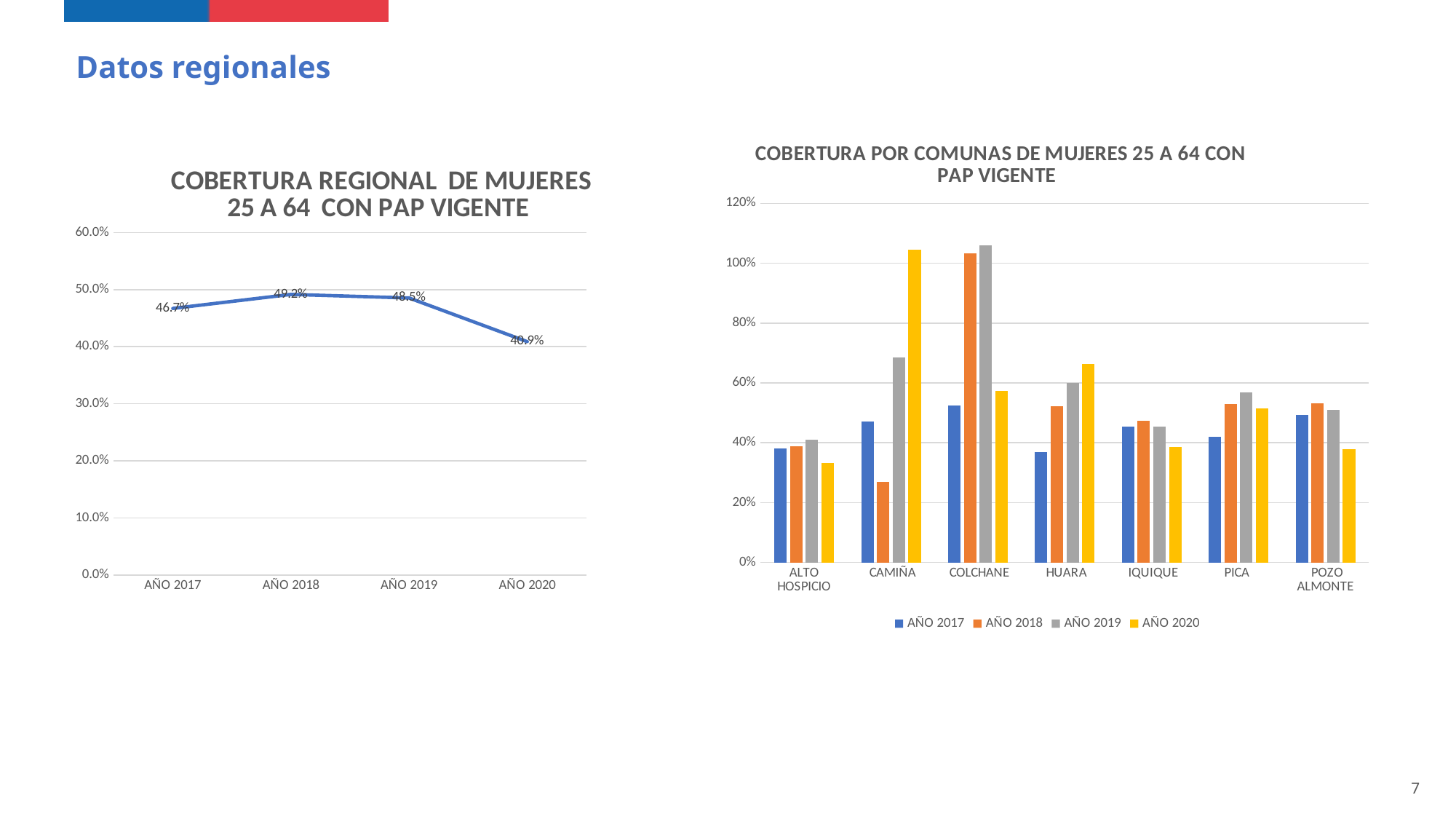
In the chart titled 'COBERTURA POR COMUNAS DE MUJERES 25 A 64 CON PAP VIGENTE', how many series does the legend list? 4 In the chart titled 'COBERTURA REGIONAL DE MUJERES 25 A 64 CON PAP VIGENTE', what is the value for AÑO 2020? 40.9% What kind of chart is the one on the right of the slide? Bar chart In the chart titled 'COBERTURA POR COMUNAS DE MUJERES 25 A 64 CON PAP VIGENTE', how many communes are shown on the x axis? 7 In the chart titled 'COBERTURA REGIONAL DE MUJERES 25 A 64 CON PAP VIGENTE', how many data points are plotted? 4 In the chart titled 'COBERTURA POR COMUNAS DE MUJERES 25 A 64 CON PAP VIGENTE', is the AÑO 2018 value for CAMIÑA greater or less than 40%? less In the chart titled 'COBERTURA POR COMUNAS DE MUJERES 25 A 64 CON PAP VIGENTE', is the AÑO 2020 value for CAMIÑA greater or less than 100%? greater In the chart titled 'COBERTURA REGIONAL DE MUJERES 25 A 64 CON PAP VIGENTE', what is the difference between the AÑO 2019 and AÑO 2020 values? 7.6% In the chart titled 'COBERTURA REGIONAL DE MUJERES 25 A 64 CON PAP VIGENTE', what is the value for AÑO 2018? 49.2% In the chart titled 'COBERTURA POR COMUNAS DE MUJERES 25 A 64 CON PAP VIGENTE', which commune has the highest AÑO 2019 value? COLCHANE What kind of chart is the one on the left of the slide? Line chart In the chart titled 'COBERTURA REGIONAL DE MUJERES 25 A 64 CON PAP VIGENTE', which year has the lowest value? AÑO 2020